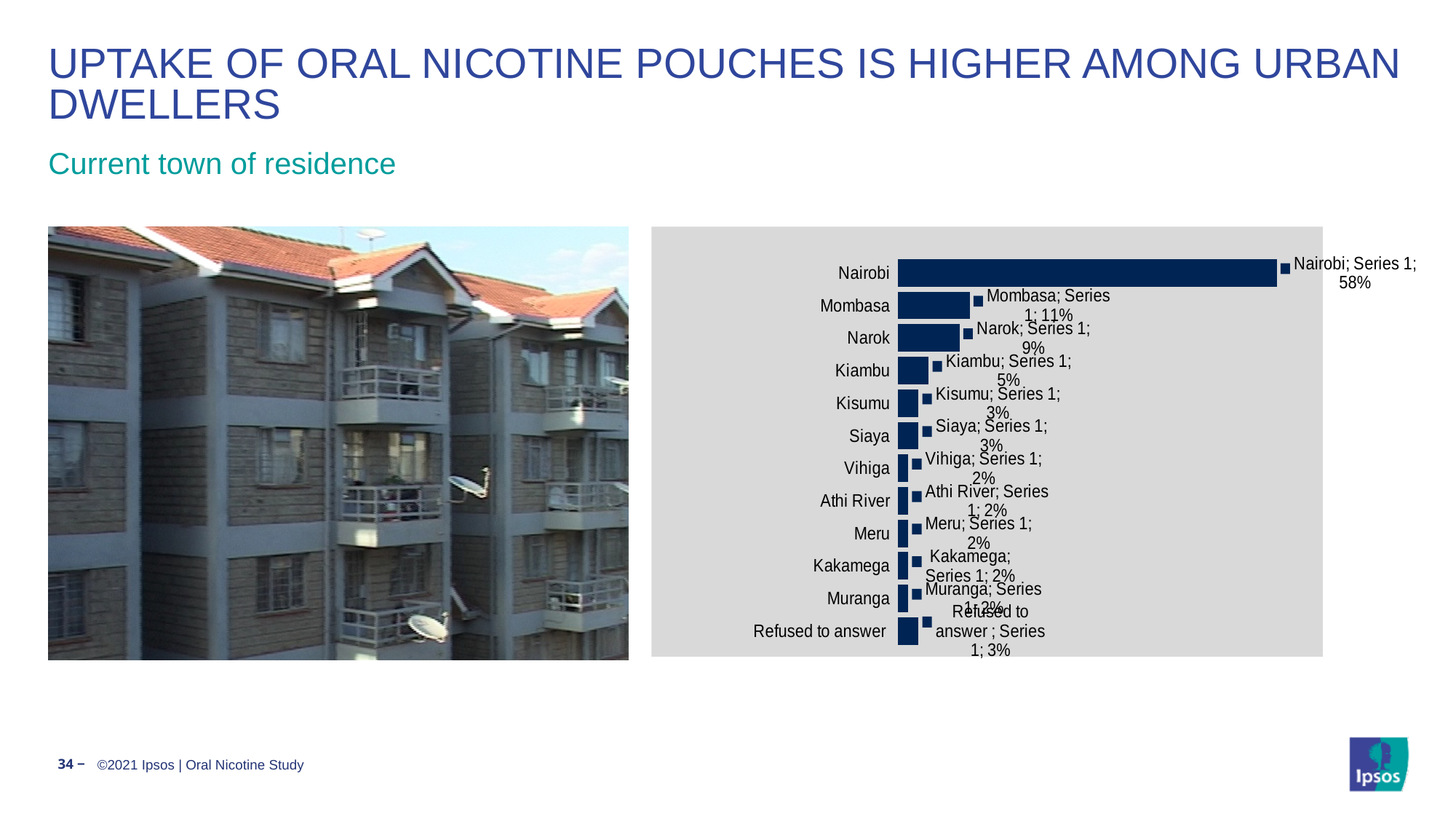
Which is larger, the value for Narok or the value for Kiambu? Narok What is the value for Mombasa? 11% What is the difference between the values for Nairobi and Mombasa? 47% What is the difference between the values for Mombasa and Narok? 2% What is the value for Narok? 9% What is the value for Kiambu? 5% How many categories are shown in the chart? 12 What is the value for Nairobi? 58% What is the value for Refused to answer? 3% What is the subtitle shown above the chart? Current town of residence What kind of chart is shown on the slide? bar chart Which town has the highest value? Nairobi